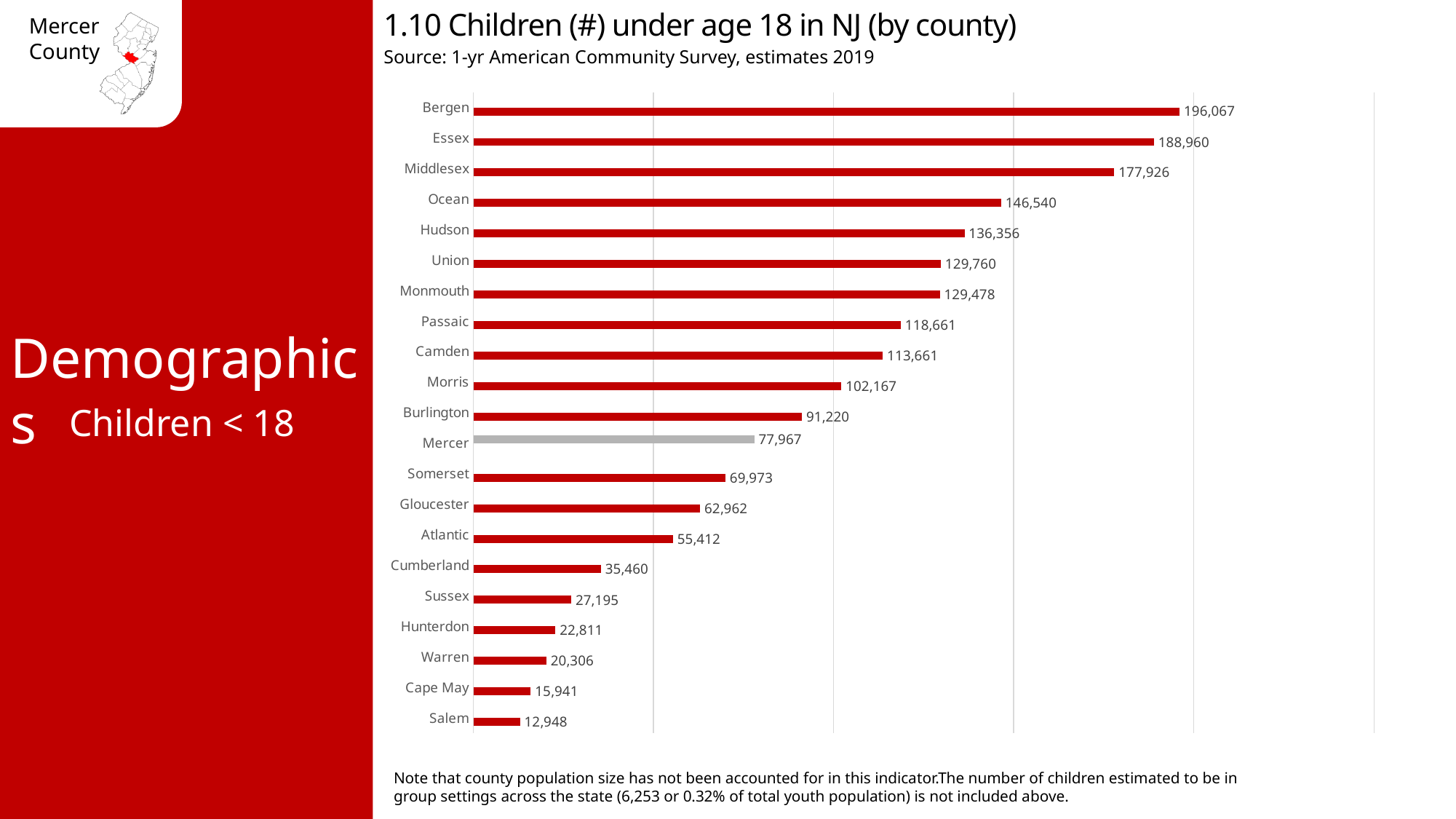
Which has more children under age 18, Ocean or Hudson? Ocean What is the difference between the values for Mercer and Somerset? 7,994 What is the number of children under age 18 in Bergen County? 196,067 Which county's bar is shown in gray instead of red? Mercer What is the difference between the values for Bergen and Essex? 7,107 What is the number of children under age 18 in Mercer County? 77,967 What type of chart is used on this slide? Bar chart How many counties are shown in the chart? 21 Which has more children under age 18, Atlantic or Gloucester? Gloucester What is the value shown for Cumberland? 35,460 Which county has the highest number of children under age 18? Bergen Which county has the lowest number of children under age 18? Salem